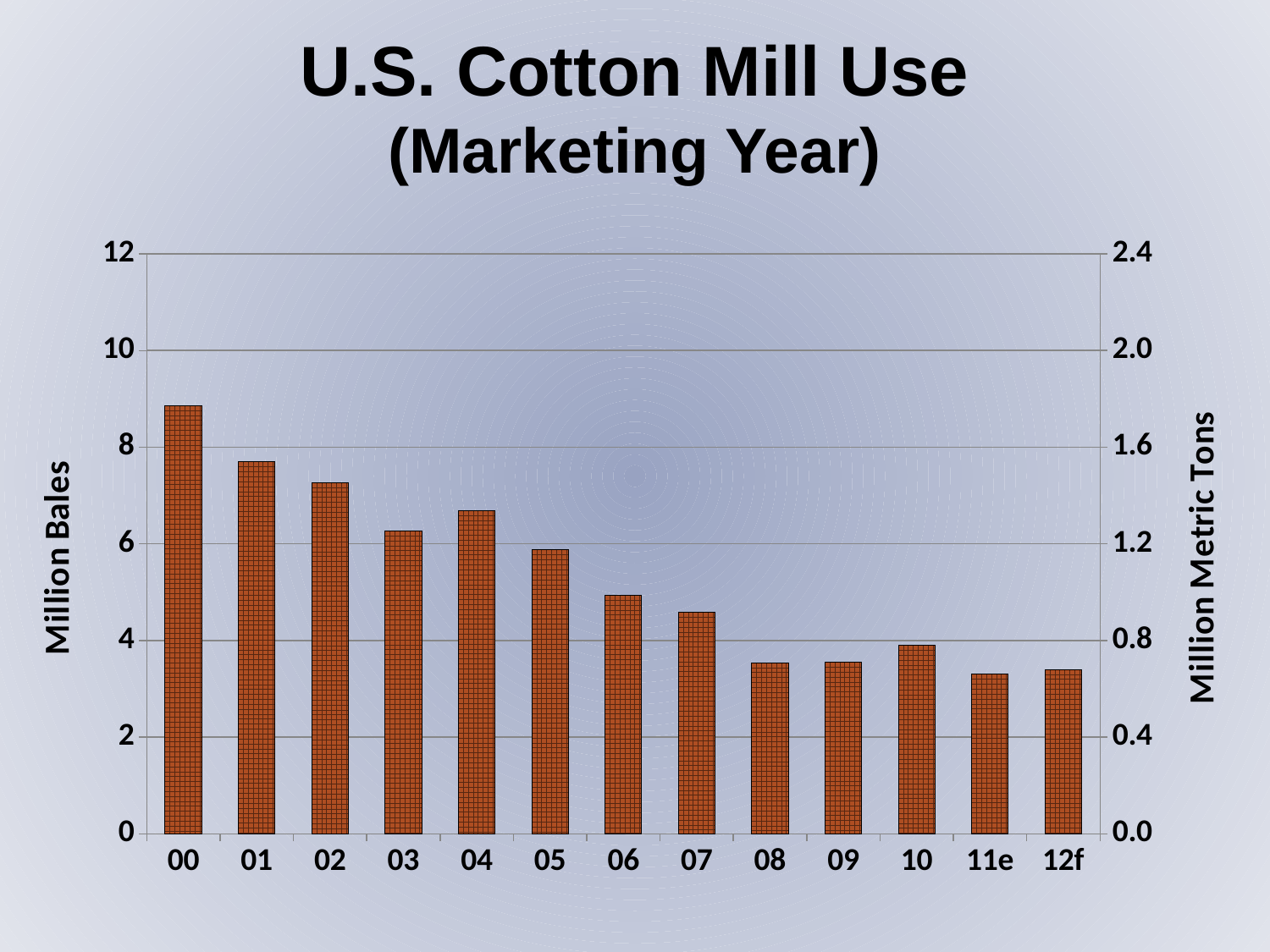
What is the label on the right-hand vertical axis? Million Metric Tons Which is larger, the value for 03 or the value for 04? 04 Which is larger, the value for 01 or the value for 02? 01 What kind of chart is shown on the slide? Bar chart Do the values generally rise or fall from 00 to 12f? Fall Is the value for 08 greater or less than 4 million bales? less Is the value for 07 greater or less than 4 million bales? greater Is the value for 04 greater or less than 6 million bales? greater Which marketing year has the highest cotton mill use? 00 How many marketing years are plotted on the chart? 13